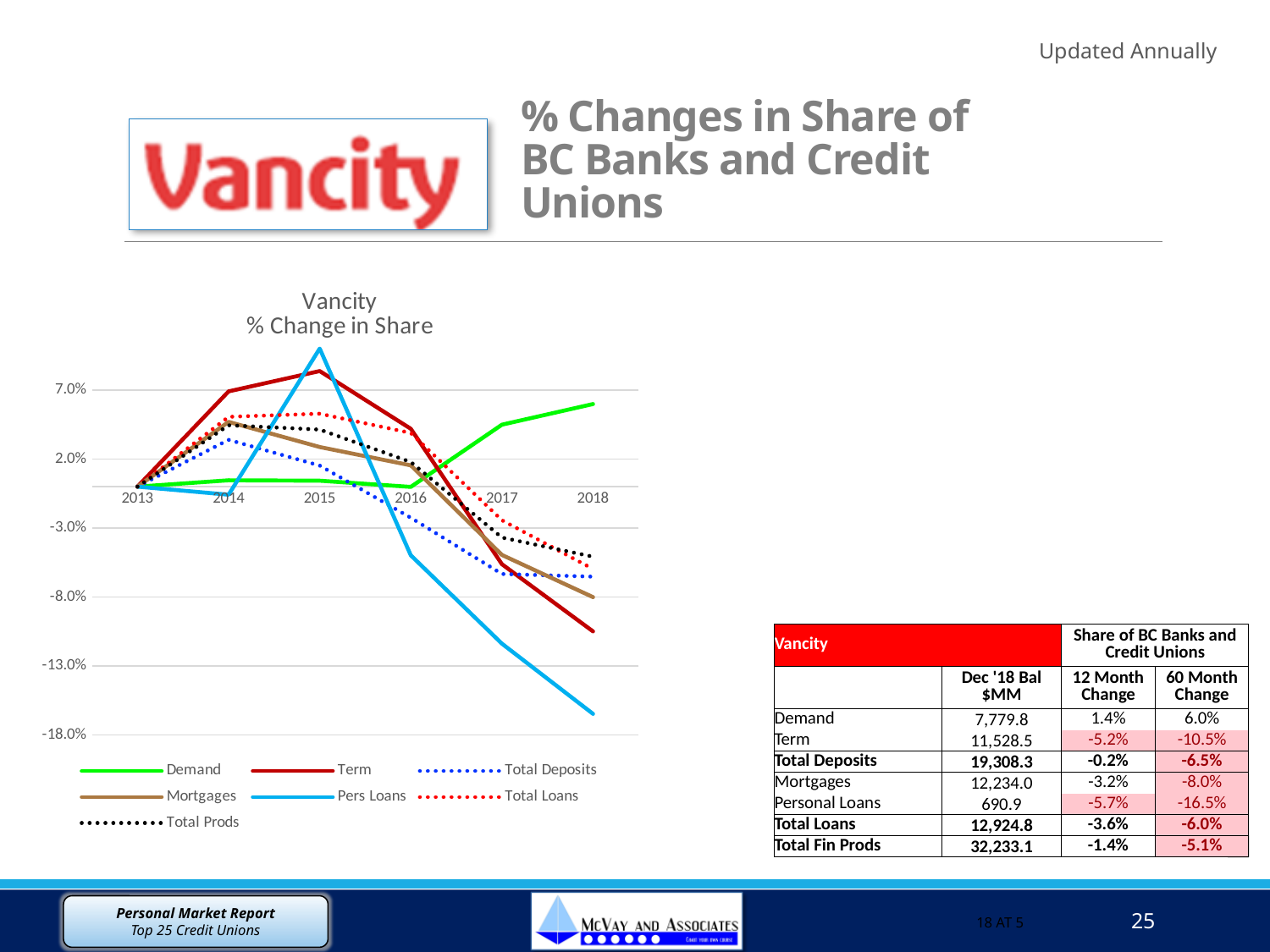
Which series has the highest value in 2018? Demand In 2018, which is larger, the value for Demand or the value for Term? Demand Is the value for Pers Loans in 2015 greater or less than 7.0%? greater Which series is drawn as a dotted blue line in the chart? Total Deposits What is the title of the chart? Vancity % Change in Share Which series has the lowest value in 2018? Pers Loans How many series does the chart legend list? 7 Is the value for Pers Loans in 2018 greater or less than -13.0%? less How many years are plotted along the x axis of the chart? 6 Does the Pers Loans line rise or fall from 2015 to 2018? fall What kind of chart is shown on the slide? line chart Is the value for Demand in 2018 greater or less than 2.0%? greater